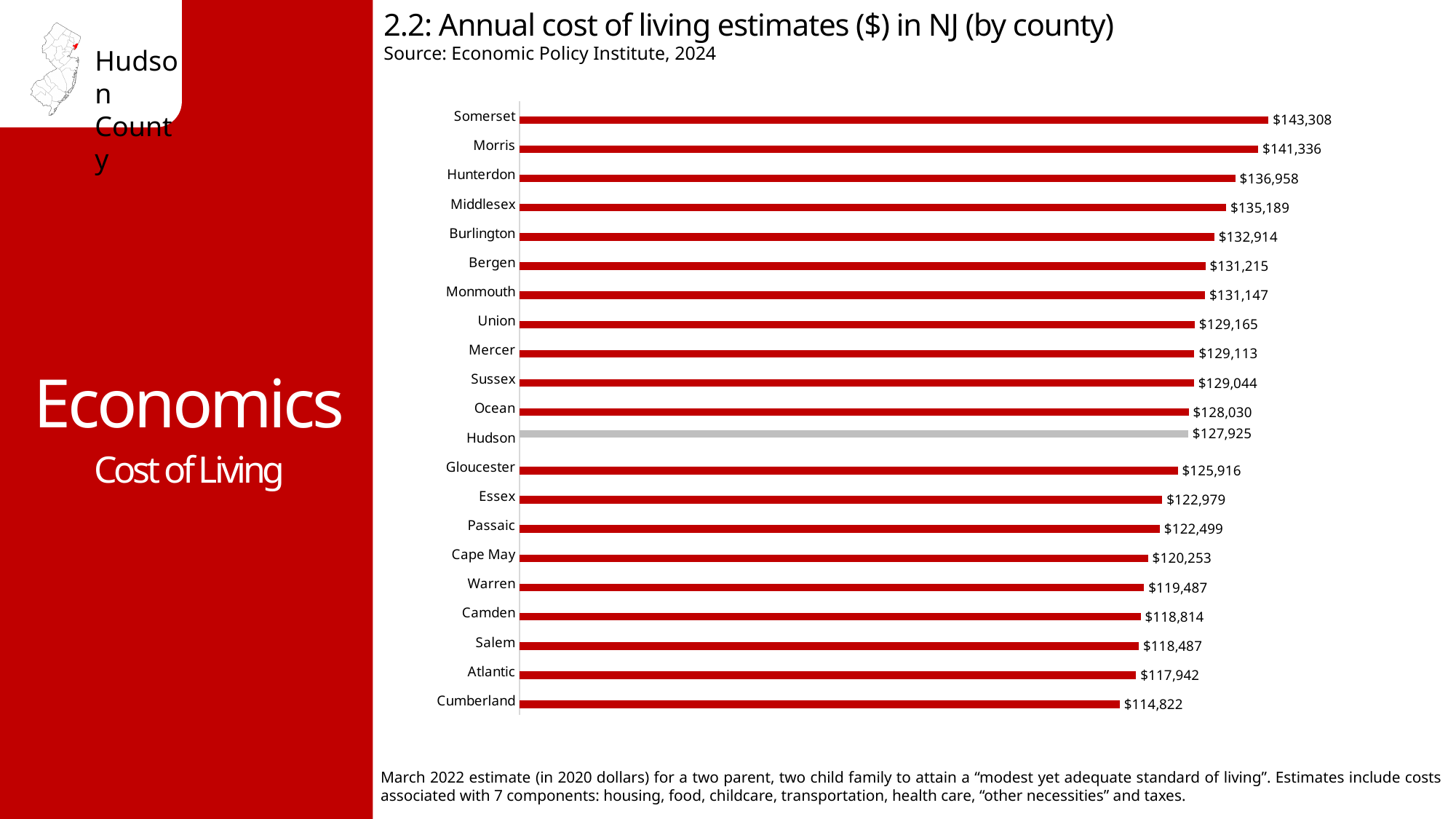
What is the annual cost of living estimate for Hudson County? $127,925 What is the annual cost of living estimate for Cape May? $120,253 Which county has the highest annual cost of living estimate? Somerset What type of chart is used on this slide? Bar chart What is the difference between the cost of living estimates for Morris and Hudson? $13,411 Which county's bar is shown in grey instead of red? Hudson Which county has the lowest annual cost of living estimate? Cumberland What is the difference between the cost of living estimates for Somerset and Cumberland? $28,486 Which has a higher cost of living estimate, Essex or Gloucester? Gloucester What is the source cited for the chart? Economic Policy Institute, 2024 What is the annual cost of living estimate for Bergen County? $131,215 How many counties are shown in the chart? 21